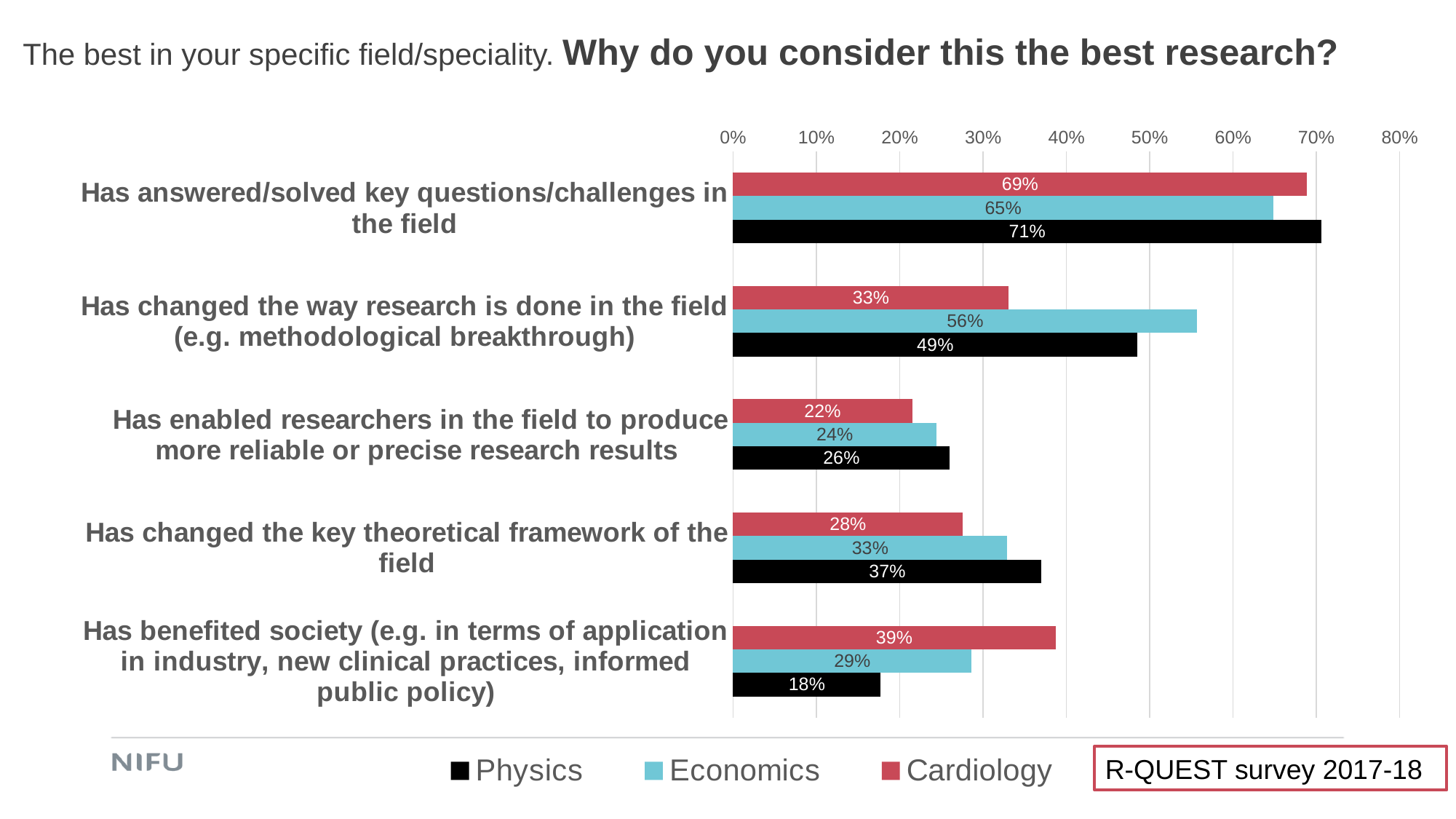
Is the Physics value for "Has changed the way research is done in the field" greater or less than 40%? greater How many categories are shown on the chart? 5 Which category has the highest Cardiology value? Has answered/solved key questions/challenges in the field Which category has the lowest Physics value? Has benefited society (e.g. in terms of application in industry, new clinical practices, informed public policy) For "Has changed the key theoretical framework of the field", which is larger: the Physics value or the Cardiology value? Physics What is the Cardiology value for "Has benefited society (e.g. in terms of application in industry, new clinical practices, informed public policy)"? 39% What is the Economics value for "Has changed the way research is done in the field (e.g. methodological breakthrough)"? 56% How many series does the legend list? 3 What is the difference between the Economics and Cardiology values for "Has changed the way research is done in the field"? 23% Which colour represents Economics in the chart? Light blue What percentage of Physics respondents chose "Has answered/solved key questions/challenges in the field"? 71% What kind of chart is shown on the slide? Bar chart